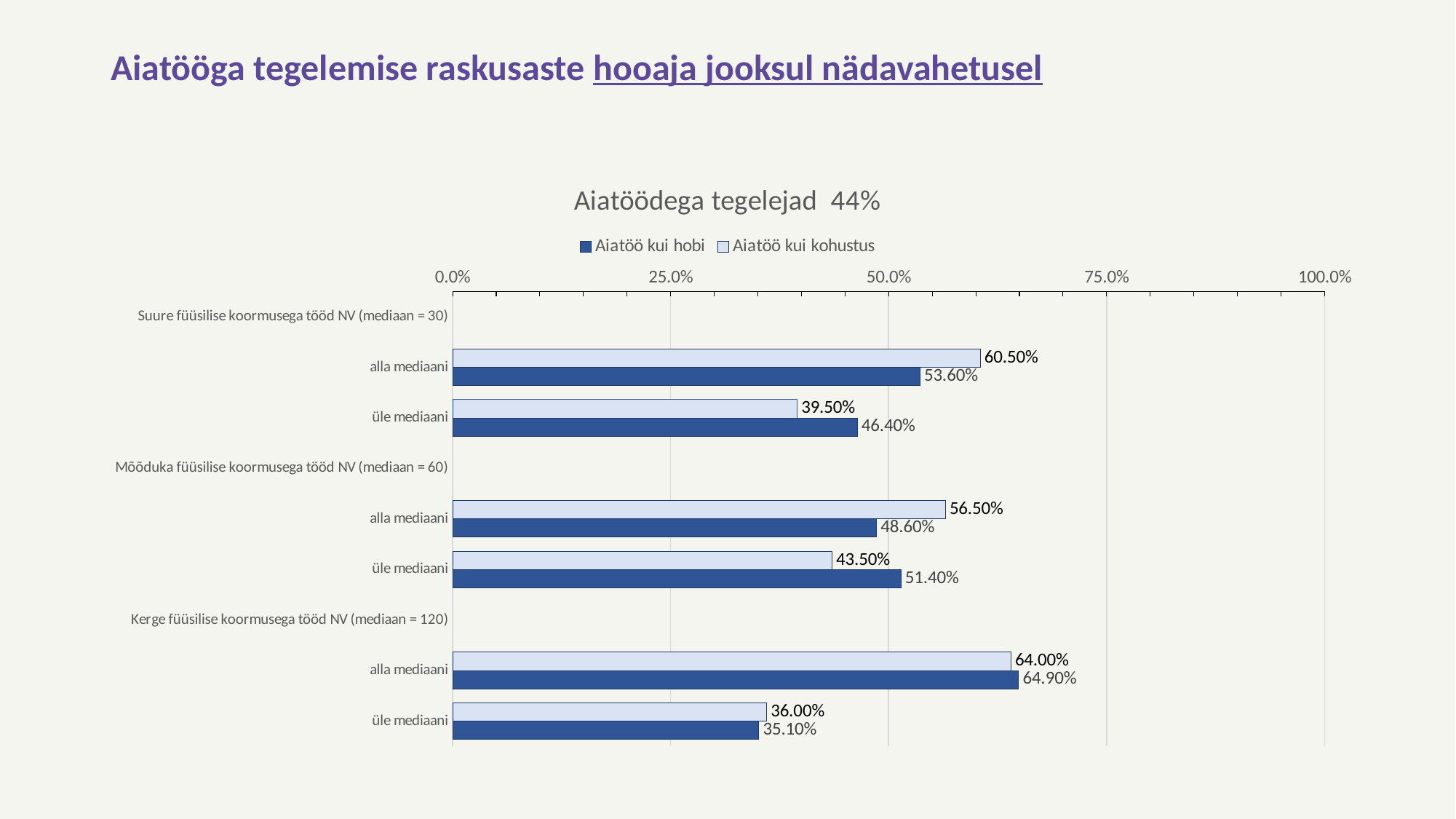
Which bar has the highest value in the chart? Aiatöö kui hobi, alla mediaani under Kerge füüsilise koormusega tööd NV (mediaan = 120) (64.90%) What is the value for 'Aiatöö kui hobi' for 'alla mediaani' under 'Mõõduka füüsilise koormusega tööd NV (mediaan = 60)'? 48.60% What is the value for 'Aiatöö kui kohustus' for 'üle mediaani' under 'Kerge füüsilise koormusega tööd NV (mediaan = 120)'? 36.00% What is the value for 'Aiatöö kui hobi' for 'üle mediaani' under 'Suure füüsilise koormusega tööd NV (mediaan = 30)'? 46.40% Which bar has the lowest value in the chart? Aiatöö kui hobi, üle mediaani under Kerge füüsilise koormusega tööd NV (mediaan = 120) (35.10%) For 'üle mediaani' under 'Mõõduka füüsilise koormusega tööd NV (mediaan = 60)', which series has the larger value? Aiatöö kui hobi What is the difference between 'Aiatöö kui kohustus' and 'Aiatöö kui hobi' for 'alla mediaani' under 'Mõõduka füüsilise koormusega tööd NV (mediaan = 60)'? 7.90% How many series does the legend list? 2 What is the title of the chart? Aiatöödega tegelejad 44% Is the value for 'Aiatöö kui kohustus' for 'üle mediaani' under 'Suure füüsilise koormusega tööd NV (mediaan = 30)' greater or less than 50.0%? less What is the value for 'Aiatöö kui kohustus' for 'alla mediaani' under 'Suure füüsilise koormusega tööd NV (mediaan = 30)'? 60.50% What type of chart is shown on the slide? bar chart